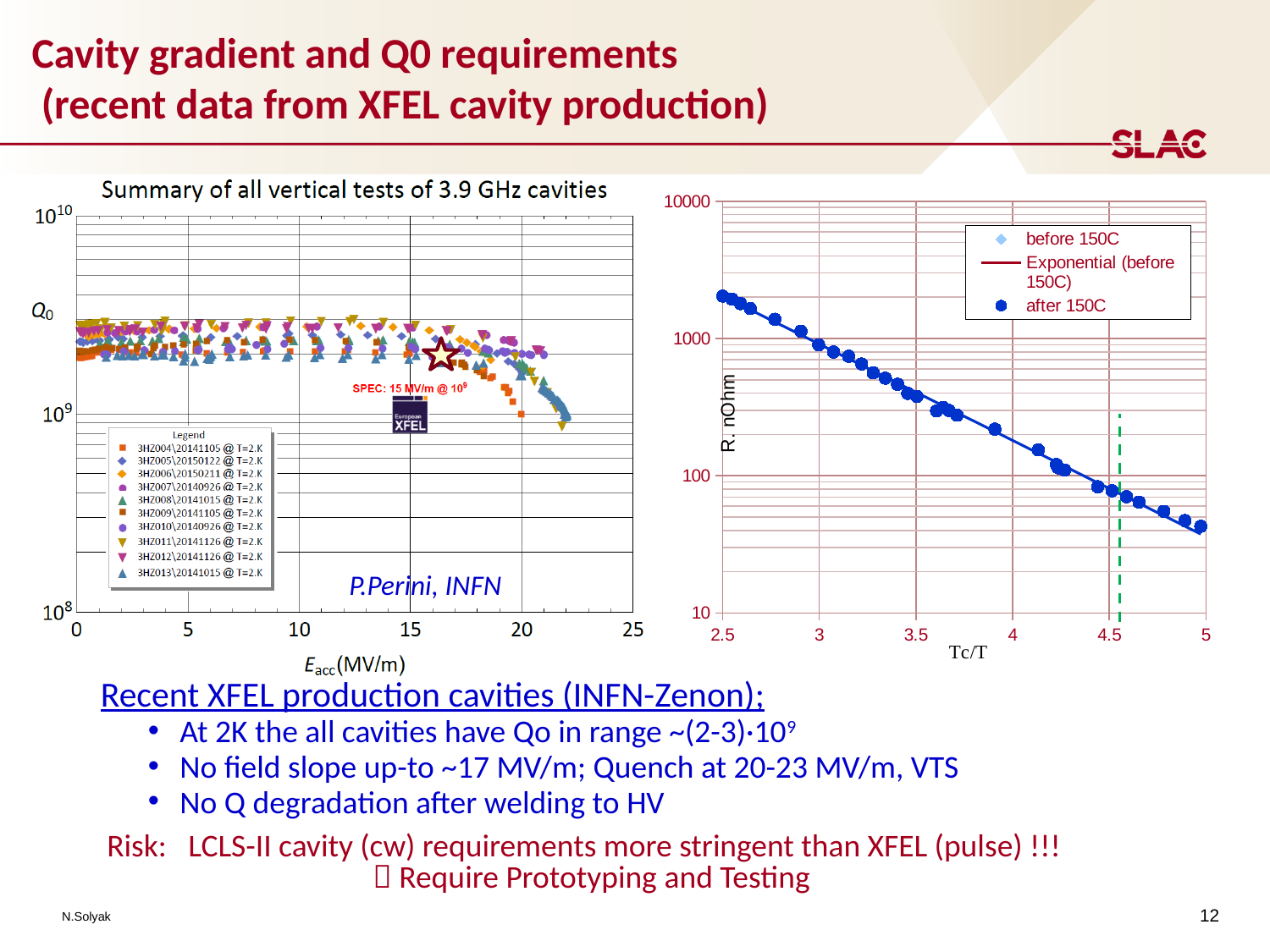
In the chart on the right (R. nOhm versus Tc/T), how many entries does the legend list? 3 In the chart on the left (Summary of all vertical tests of 3.9 GHz cavities), how many cavity series does the legend list? 10 In the chart on the left (Summary of all vertical tests of 3.9 GHz cavities), is the Q0 of the cavities at 5 MV/m greater or less than 10^9? greater What kind of chart is the chart on the right of the slide (R. nOhm versus Tc/T)? scatter chart with a fitted line In the chart on the right (R. nOhm versus Tc/T), is the value of R at Tc/T = 5 greater or less than 100 nOhm? less In the chart on the left (Summary of all vertical tests of 3.9 GHz cavities), what is the highest value shown on the Q0 axis? 10^10 In the chart on the left (Summary of all vertical tests of 3.9 GHz cavities), what specification is annotated on the plot? SPEC: 15 MV/m @ 10^9 What is the title of the chart on the left of the slide? Summary of all vertical tests of 3.9 GHz cavities In the chart on the right (R. nOhm versus Tc/T), do the values rise or fall as Tc/T increases? fall In the chart on the right (R. nOhm versus Tc/T), what is the label of the x axis? Tc/T In the chart on the left (Summary of all vertical tests of 3.9 GHz cavities), what is the label of the x axis? Eacc (MV/m) In the chart on the right (R. nOhm versus Tc/T), is the value of R at Tc/T = 2.5 greater or less than 1000 nOhm? greater